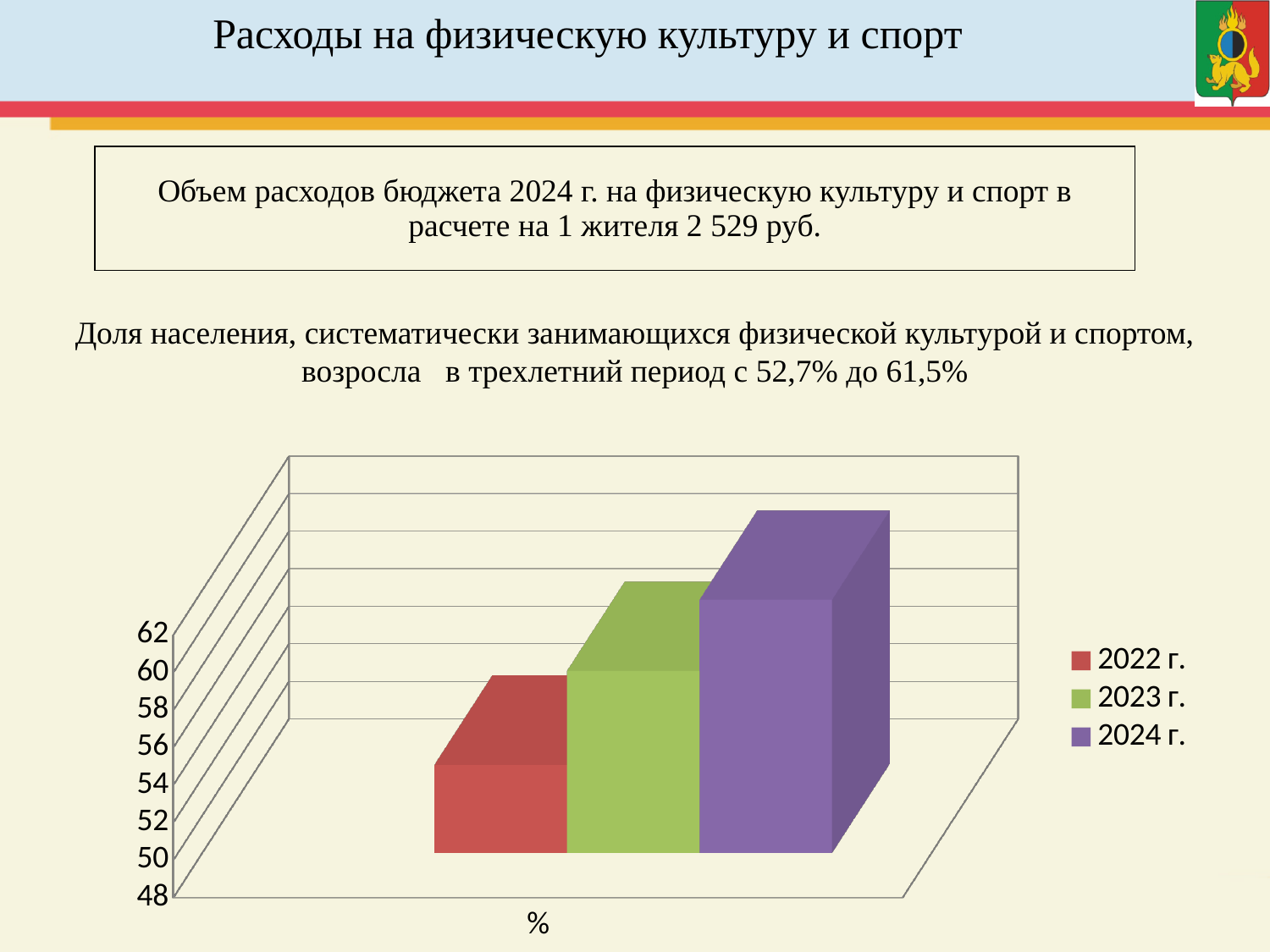
Is the value for 2024 г. greater or less than 56? greater Is the value for 2022 г. greater or less than 58? less What colour is the bar for 2024 г. in the chart? purple Is the value for 2023 г. greater or less than 52? greater What kind of chart is shown on the slide? bar chart Which is larger, the bar for 2023 г. or the bar for 2022 г.? 2023 г. Which year has the lowest bar in the chart? 2022 г. How many bars are plotted in the chart? 3 How many series does the chart legend list? 3 Do the bars rise or fall from 2022 г. to 2024 г.? rise Which year has the highest bar in the chart? 2024 г. What label is shown below the chart's horizontal axis? %